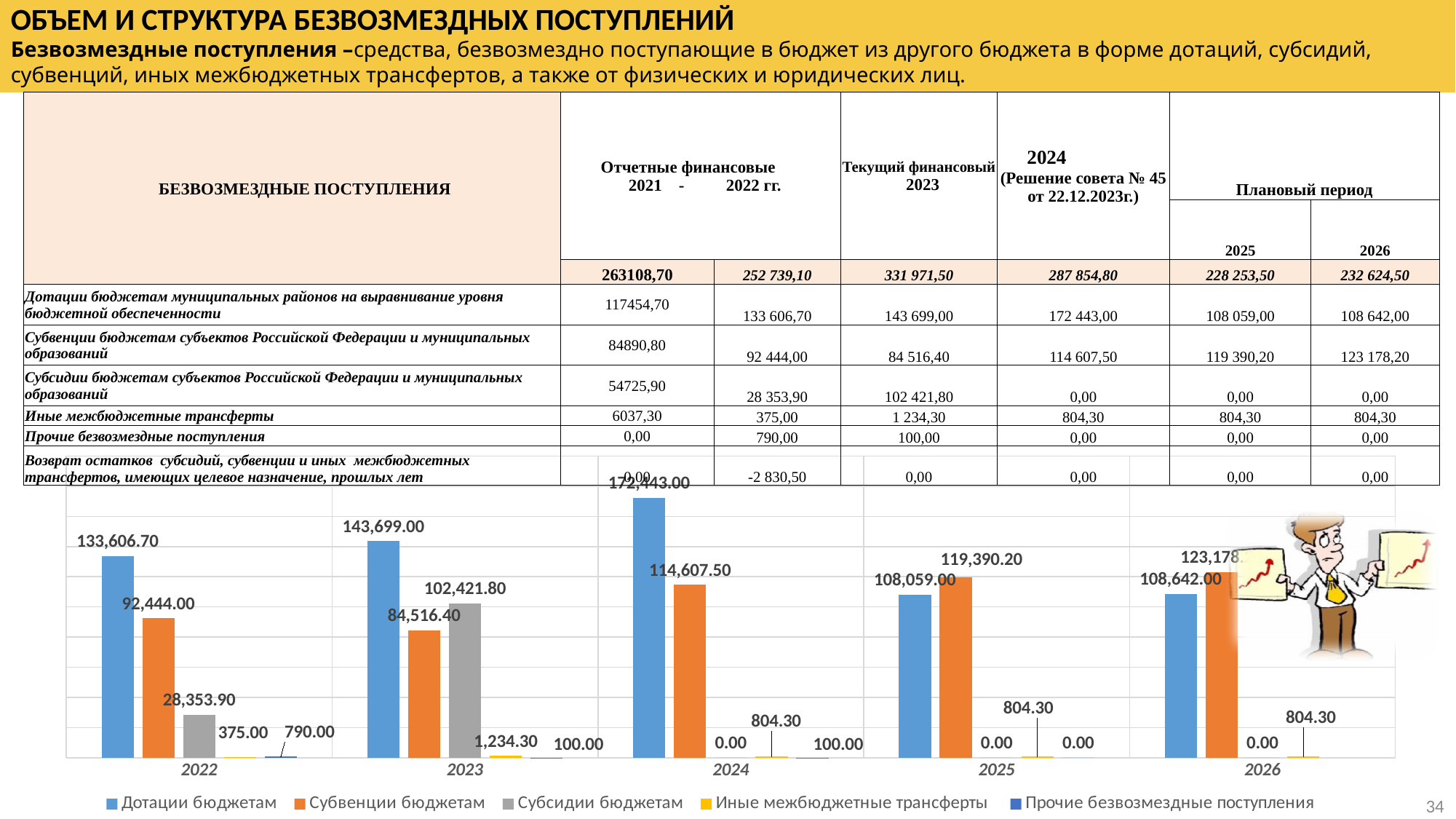
How many series does the legend of the bar chart list? 5 In the bar chart, for 2025, which is larger: Дотации бюджетам or Субвенции бюджетам? Субвенции бюджетам In the bar chart, which year has the highest value for Дотации бюджетам? 2024 In the bar chart, what is the value of Дотации бюджетам for 2022? 133,606.70 What kind of chart is shown at the bottom of the slide? bar chart In the bar chart, what colour represents Субвенции бюджетам? orange How many years are shown on the x axis of the bar chart? 5 In the bar chart, what is the value of Иные межбюджетные трансферты for 2024? 804.30 In the bar chart, do the values for Субвенции бюджетам rise or fall from 2024 to 2026? rise In the bar chart, what is the value of Субсидии бюджетам for 2023? 102,421.80 In the bar chart, what is the value of Субвенции бюджетам for 2025? 119,390.20 In the bar chart, what is the difference between Дотации бюджетам and Субвенции бюджетам in 2023? 59,182.60